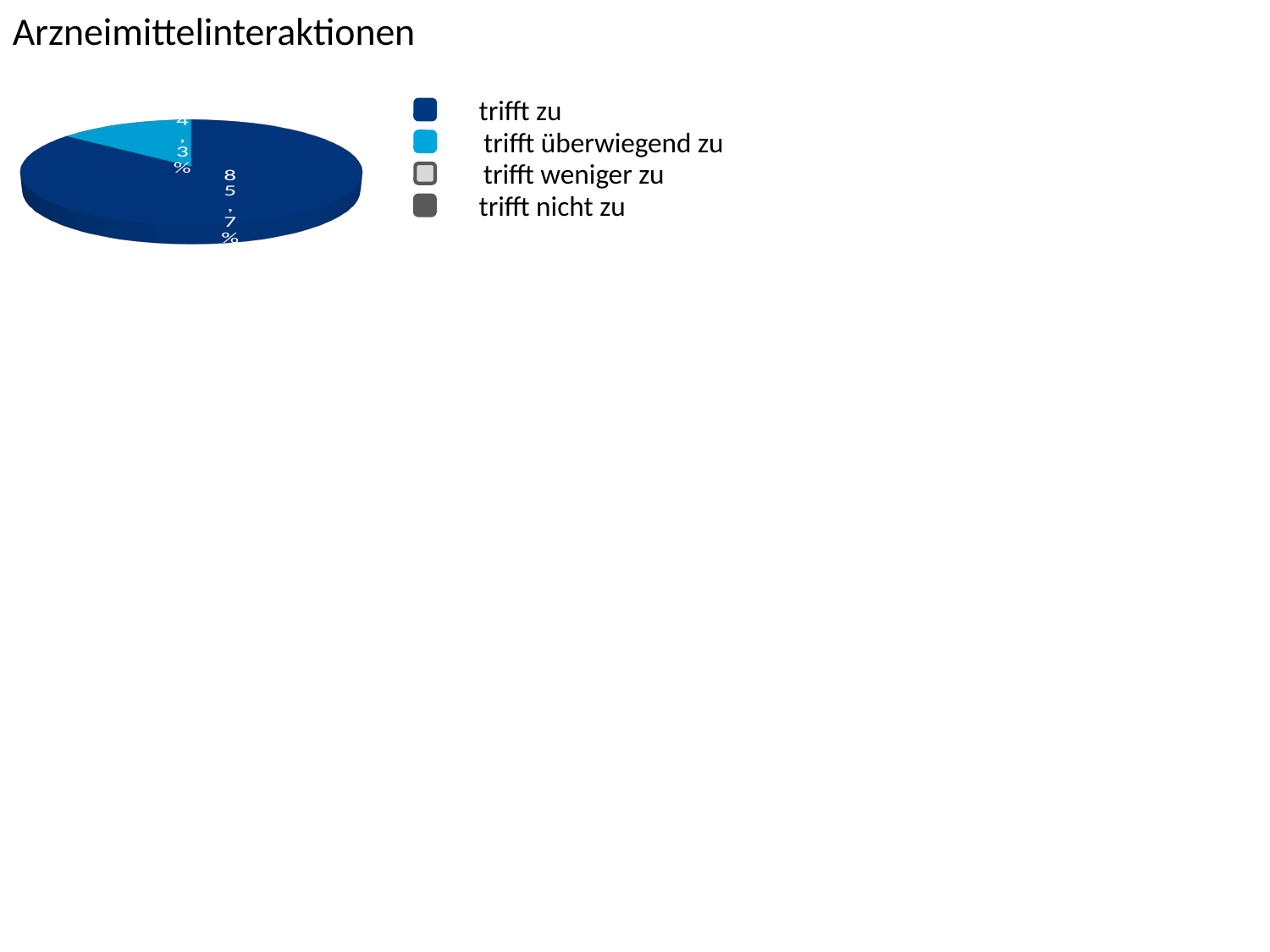
How many entries does the legend of the pie chart list? 4 What is the title of the slide with the pie chart? Arzneimittelinteraktionen What kind of chart is shown on the slide? pie chart Which is larger in the pie chart, 'trifft zu' or 'trifft überwiegend zu'? trifft zu Which legend entry is shown in light blue? trifft überwiegend zu What percentage is shown for the 'trifft zu' slice of the pie chart? 85,7% Is the share of 'trifft zu' in the pie chart greater or less than 50%? greater Which category has the largest slice in the pie chart? trifft zu